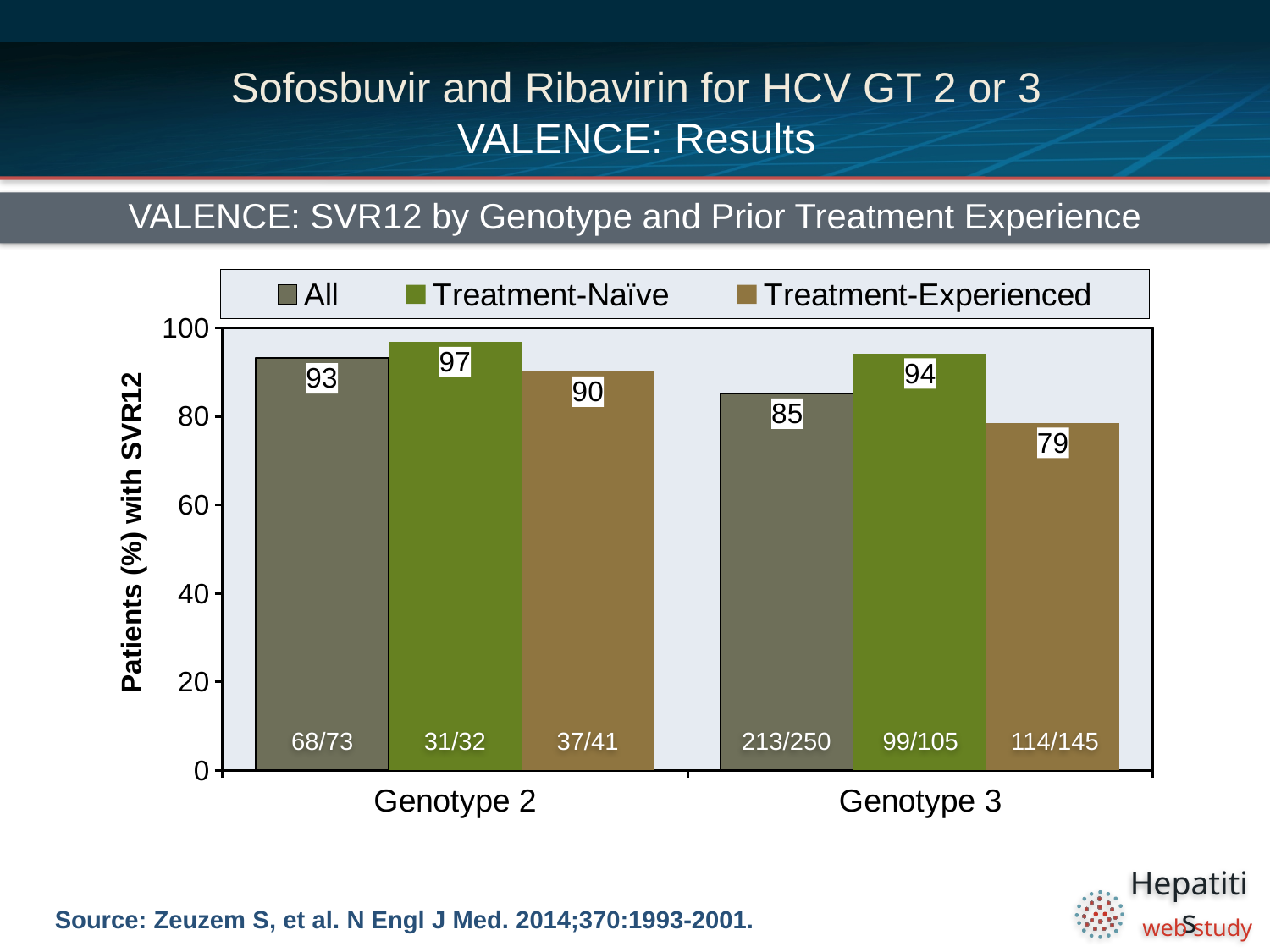
What is the SVR12 rate for Treatment-Experienced patients in Genotype 3? 79 Is the Treatment-Experienced SVR12 rate for Genotype 3 greater or less than 80? less What fraction of patients is printed on the Treatment-Naïve bar for Genotype 3? 99/105 What is the difference between the Treatment-Naïve and Treatment-Experienced SVR12 rates in Genotype 3? 15 How many series does the legend list? 3 Which is larger, the All SVR12 rate for Genotype 2 or for Genotype 3? Genotype 2 Which series has the lowest SVR12 rate in Genotype 2? Treatment-Experienced What kind of chart is shown on the slide? bar chart What is the SVR12 rate for Treatment-Naïve patients in Genotype 2? 97 How many genotype categories are shown on the x axis? 2 What is the SVR12 rate for the All group in Genotype 2? 93 Which series has the highest SVR12 rate in Genotype 3? Treatment-Naïve